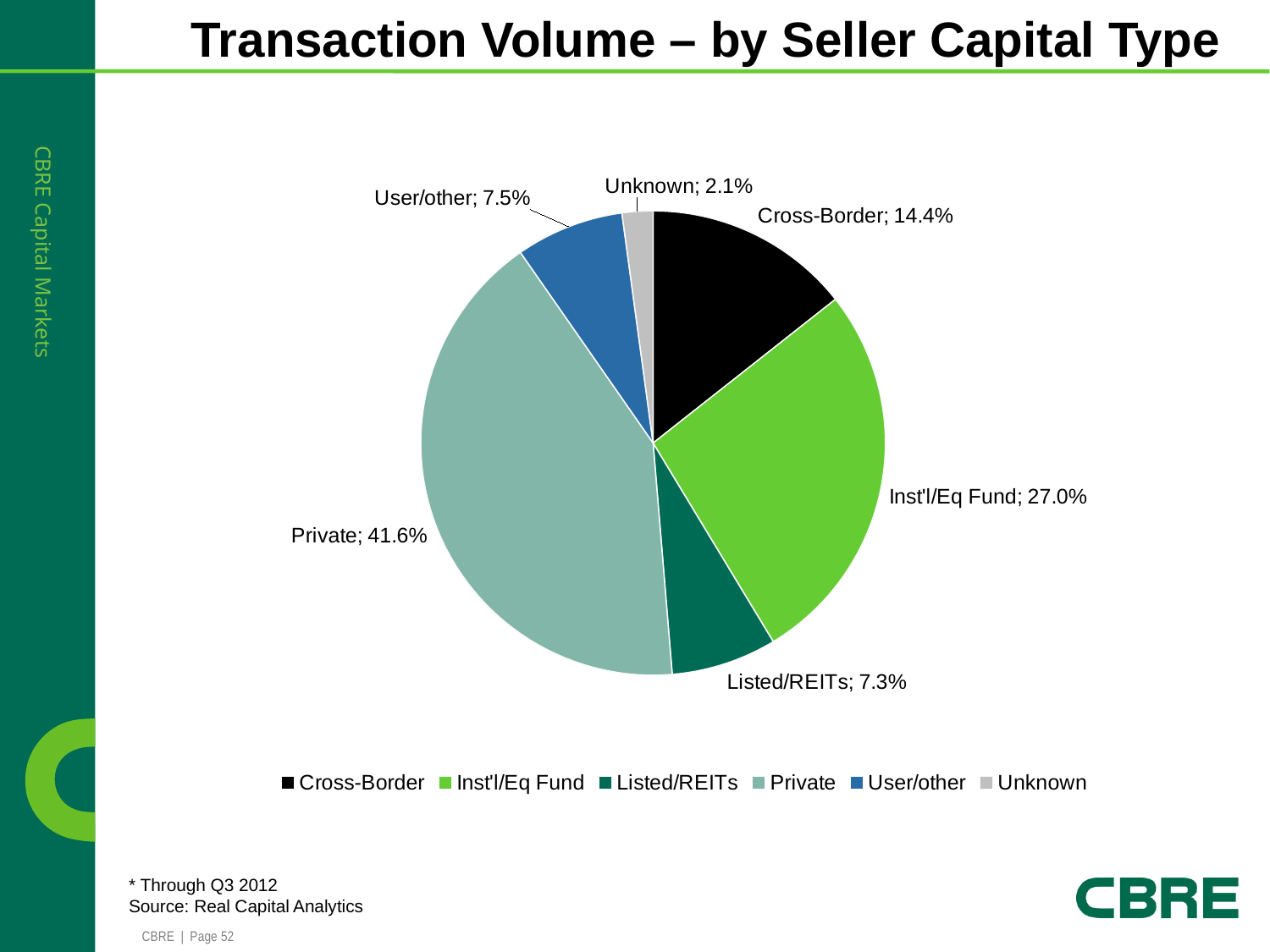
Which has a larger share of transaction volume, Cross-Border or User/other? Cross-Border What type of chart is shown on the slide? pie chart What share of transaction volume is attributed to Unknown seller capital type? 2.1% What is the difference in share between Private and Inst'l/Eq Fund sellers? 14.6% Which seller capital type has the smallest share of transaction volume? Unknown What share of transaction volume is attributed to Inst'l/Eq Fund sellers? 27.0% What is the title of the chart? Transaction Volume – by Seller Capital Type Which seller capital type has the largest share of transaction volume? Private What share of transaction volume is attributed to Cross-Border sellers? 14.4% How many seller capital types are shown in the pie chart? 6 What share of transaction volume is attributed to Listed/REITs? 7.3% What share of transaction volume is attributed to Private sellers? 41.6%